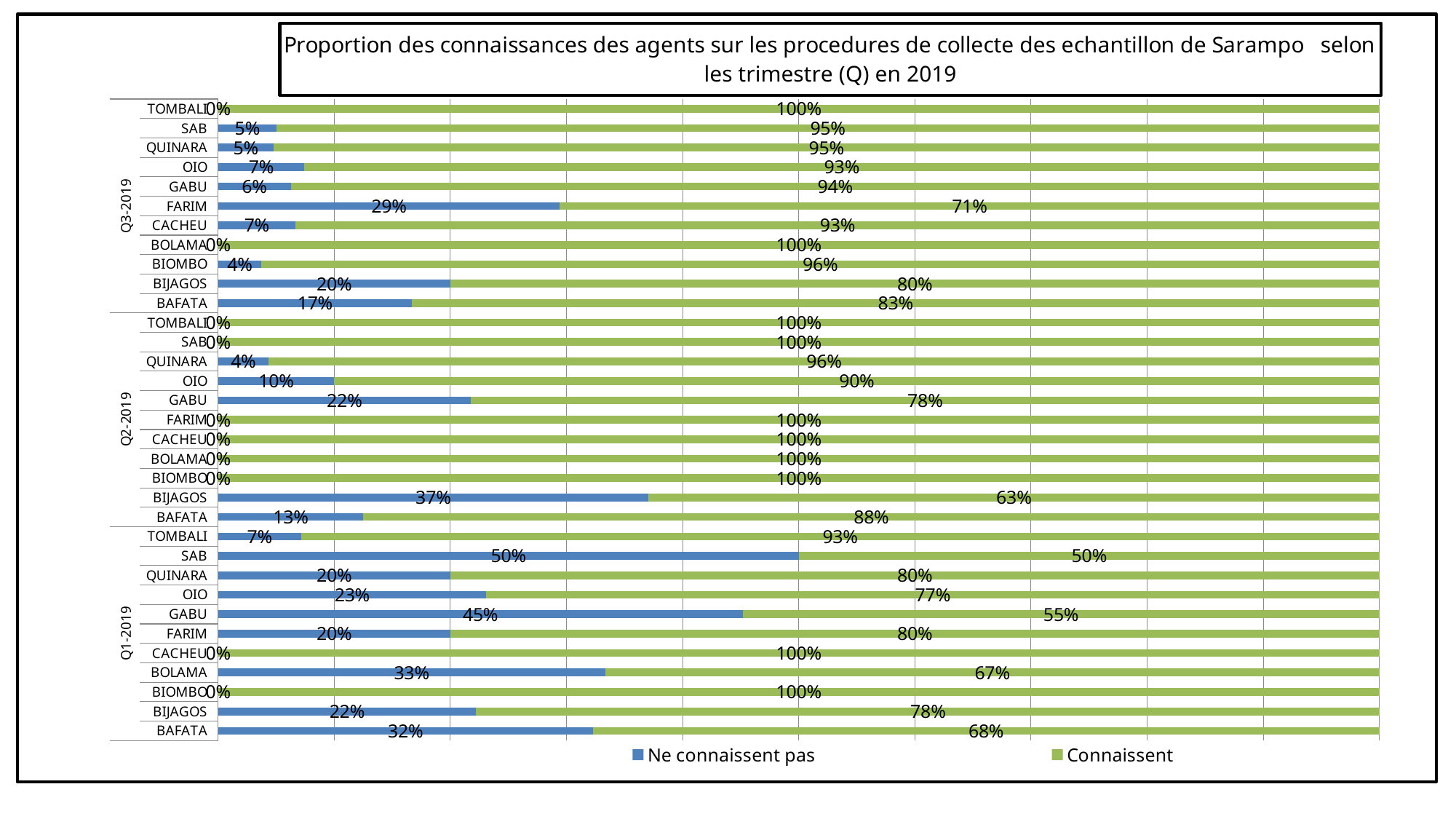
What kind of chart is shown on the slide? Stacked bar chart How many regions are listed within each quarter group? 11 In Q1-2019, which has the larger 'Ne connaissent pas' value, BOLAMA or BIJAGOS? BOLAMA Within Q3-2019, which region has the highest 'Ne connaissent pas' value? FARIM Within Q2-2019, which region has the lowest 'Connaissent' value? BIJAGOS What is the 'Ne connaissent pas' value for BIJAGOS in Q2-2019? 37% Within Q1-2019, which region has the highest 'Ne connaissent pas' value? SAB For BAFATA in Q1-2019, what is the difference between the 'Connaissent' and 'Ne connaissent pas' values? 36% What is the 'Connaissent' value for GABU in Q1-2019? 55% What is the 'Ne connaissent pas' value for FARIM in Q3-2019? 29% How many series does the legend list? 2 What is the 'Connaissent' value for SAB in Q1-2019? 50%